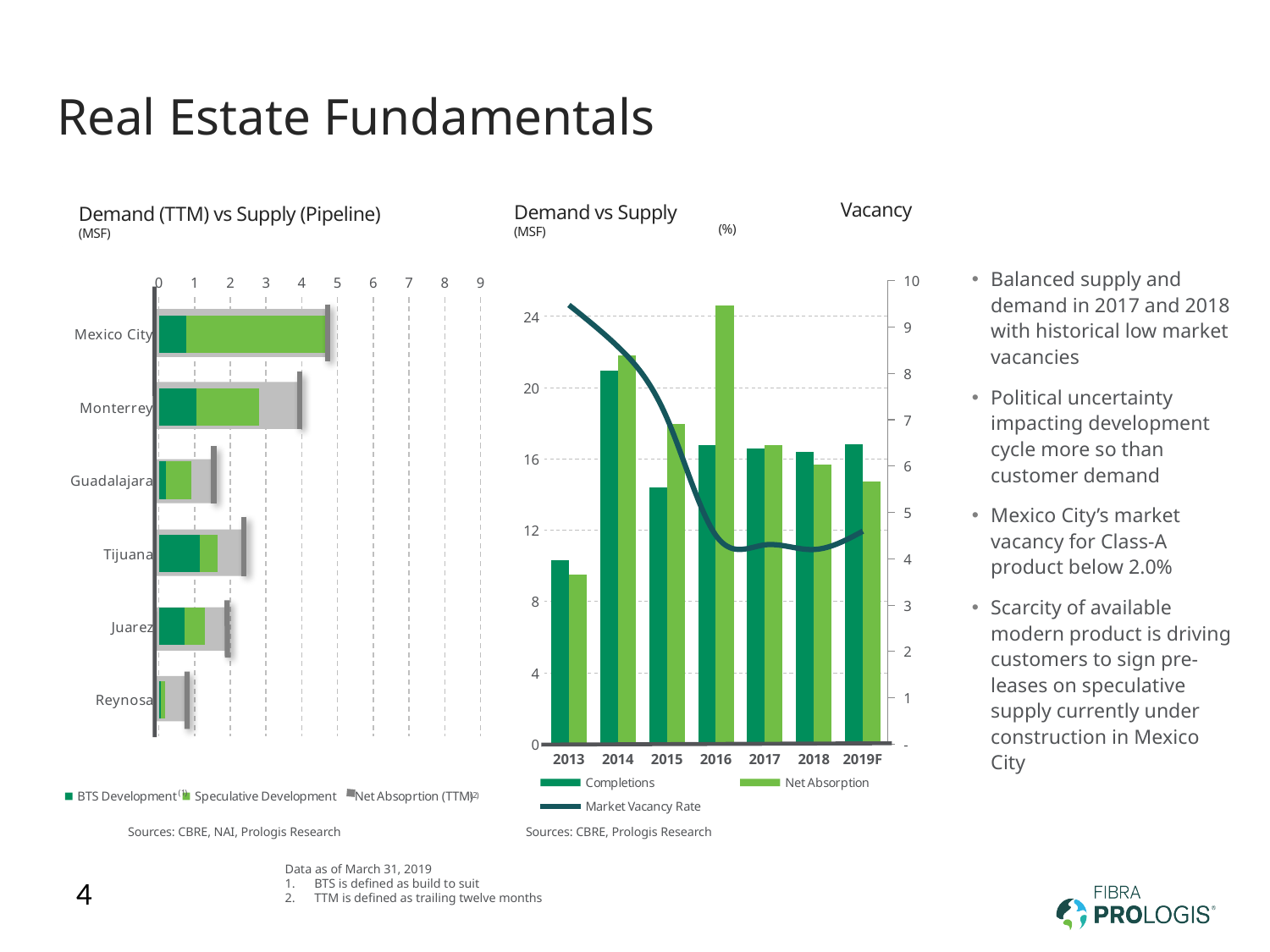
In the Demand (TTM) vs Supply (Pipeline) chart, which market has the longest bar? Mexico City How many series does the legend of the Demand (TTM) vs Supply (Pipeline) chart list? 3 In the Demand (TTM) vs Supply (Pipeline) chart, how many markets are listed on the vertical axis? 6 In the Demand vs Supply chart, which year has the highest Net Absorption bar? 2016 In the Demand (TTM) vs Supply (Pipeline) chart, which market has the shortest bar? Reynosa In the Demand (TTM) vs Supply (Pipeline) chart, is the Net Absorption (TTM) value for Mexico City greater or less than 4? greater In the Demand vs Supply chart, which is larger in 2016: Completions or Net Absorption? Net Absorption In the Demand vs Supply chart, does the Market Vacancy Rate line rise or fall from 2013 to 2016? fall In the Demand vs Supply chart, is the Completions value for 2014 greater or less than 20? greater In the Demand vs Supply chart, which year has the lowest Completions bar? 2013 In the Demand (TTM) vs Supply (Pipeline) chart, is the Net Absorption (TTM) value for Reynosa greater or less than 1? less What kind of chart is the Demand vs Supply chart? bar chart with a line